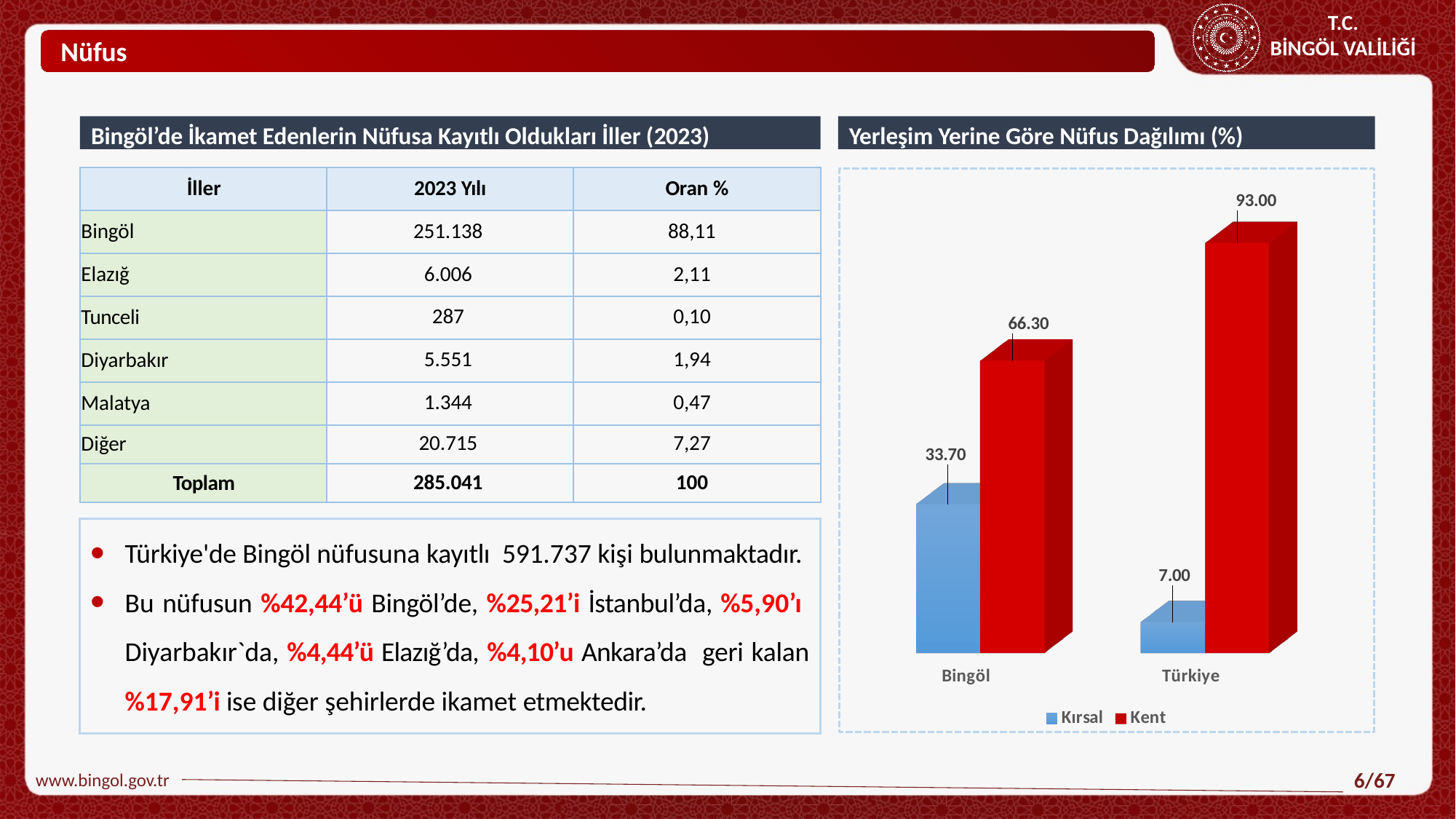
What is the Kent value for Türkiye in the chart? 93.00 What is the difference between the Kent and Kırsal values for Bingöl? 32.60 What type of chart is shown on the slide? Bar chart What is the difference between the Kent values for Türkiye and Bingöl? 26.70 Which category has the lowest Kırsal value in the chart? Türkiye Which category has the highest Kent value in the chart? Türkiye What is the Kent value for Bingöl in the chart? 66.30 What is the Kırsal value for Türkiye in the chart? 7.00 How many categories are shown on the x axis of the chart? 2 Which is larger: the Kırsal value for Bingöl or the Kırsal value for Türkiye? Bingöl What is the Kırsal value for Bingöl in the chart? 33.70 How many series does the chart legend list? 2